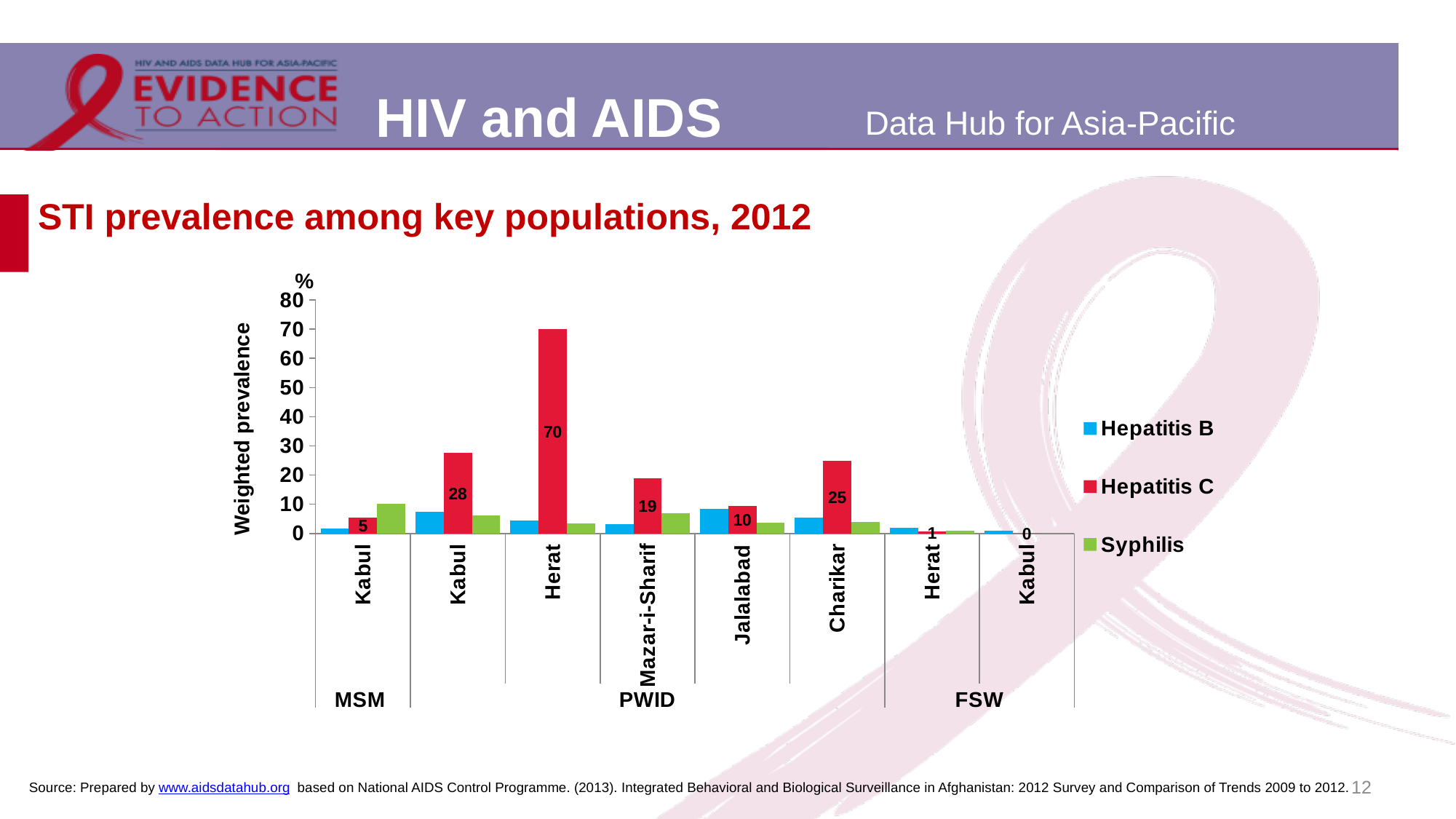
What is the Hepatitis C prevalence among PWID in Charikar? 25 Which city and population group has the highest Hepatitis C prevalence? Herat (PWID) What is the difference in Hepatitis C prevalence between PWID in Herat and PWID in Kabul? 42 How many city bars groups are shown along the x axis? 8 What is the Hepatitis C prevalence among PWID in Kabul? 28 Which has a higher Hepatitis C prevalence: PWID in Mazar-i-Sharif or PWID in Jalalabad? Mazar-i-Sharif What is the Hepatitis C prevalence among PWID in Herat? 70 What is the Hepatitis C prevalence among MSM in Kabul? 5 Is the Hepatitis B prevalence among PWID in Jalalabad greater or less than 10? less What kind of chart is shown on the slide? Bar chart What is the Hepatitis C prevalence among FSW in Kabul? 0 How many series does the legend list? 3